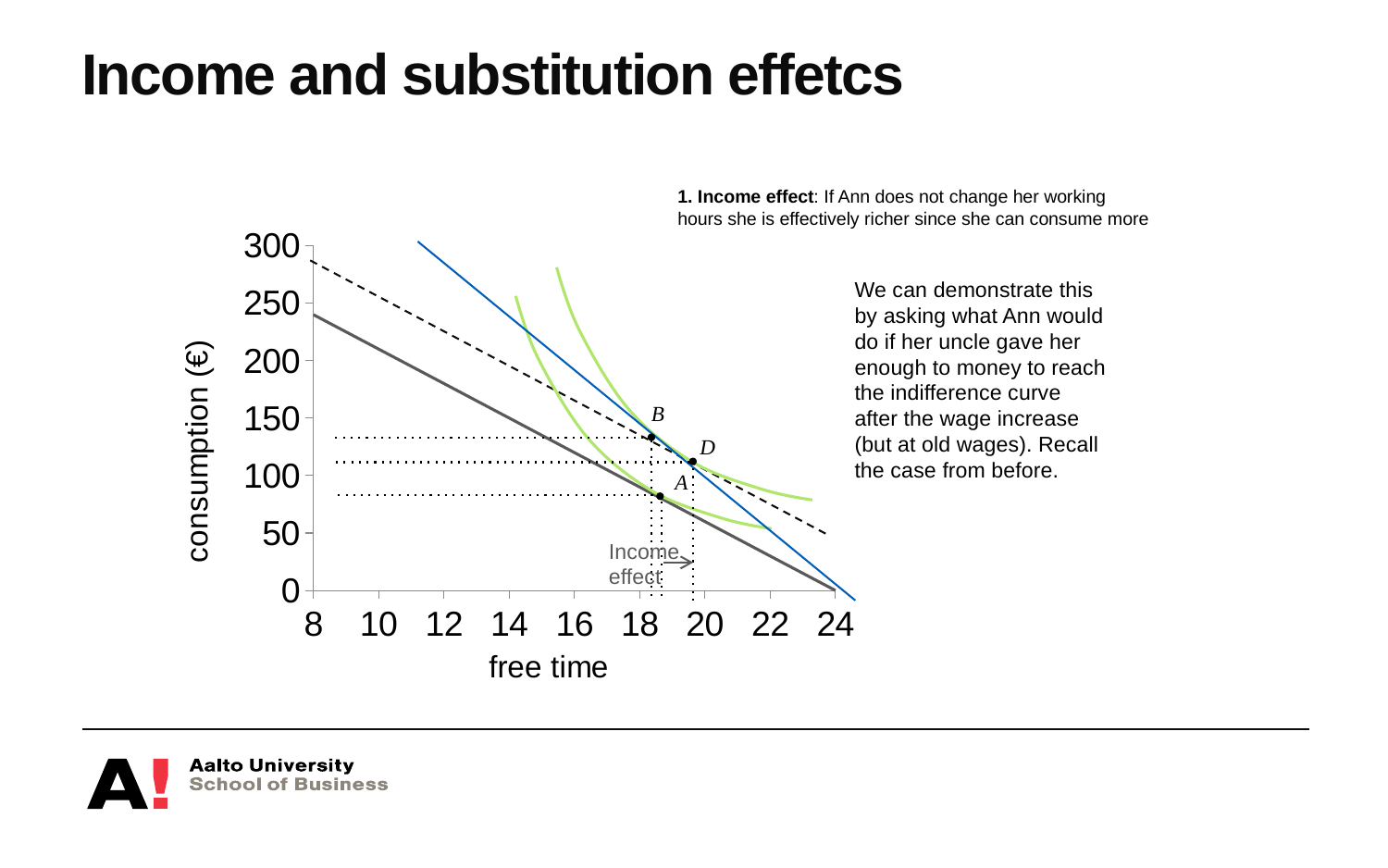
Which of the labeled points A, B and D has the lowest consumption? A Does consumption along the solid grey budget line rise or fall as free time increases? fall Is the consumption value at point B greater or less than 150? less What is the title of the slide containing the chart? Income and substitution effetcs What is the label of the x axis of the chart? free time Is the consumption value at point B greater or less than 100? greater Is the consumption value at point D greater or less than 100? greater What kind of chart is shown on the slide? line chart How many labeled points (A, B, D) are marked on the chart? 3 Which of the labeled points A, B and D has the highest consumption? B Which point has higher consumption, A or B? B